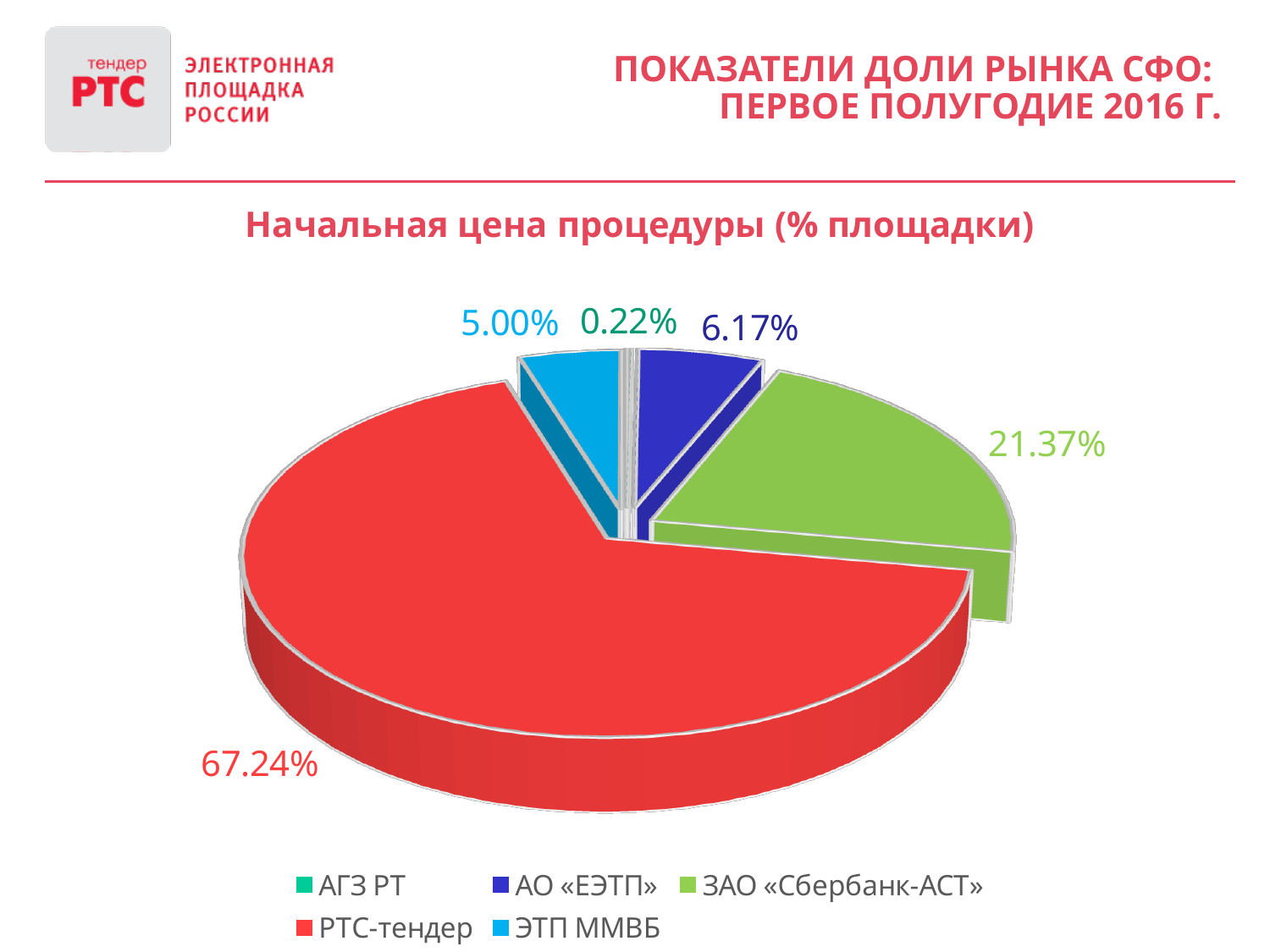
What is the difference between the shares of РТС-тендер and ЗАО «Сбербанк-АСТ»? 45.87% Which platform has the largest share of the pie? РТС-тендер What is the share for ЭТП ММВБ? 5.00% What is the share for РТС-тендер? 67.24% What kind of chart is shown on the slide? pie chart What is the title of the chart? Начальная цена процедуры (% площадки) Which platform has the smallest share of the pie? АГЗ РТ How many platforms does the legend list? 5 What is the share for ЗАО «Сбербанк-АСТ»? 21.37% Which has a larger share, АО «ЕЭТП» or ЭТП ММВБ? АО «ЕЭТП» What is the share for АГЗ РТ? 0.22% What is the share for АО «ЕЭТП»? 6.17%